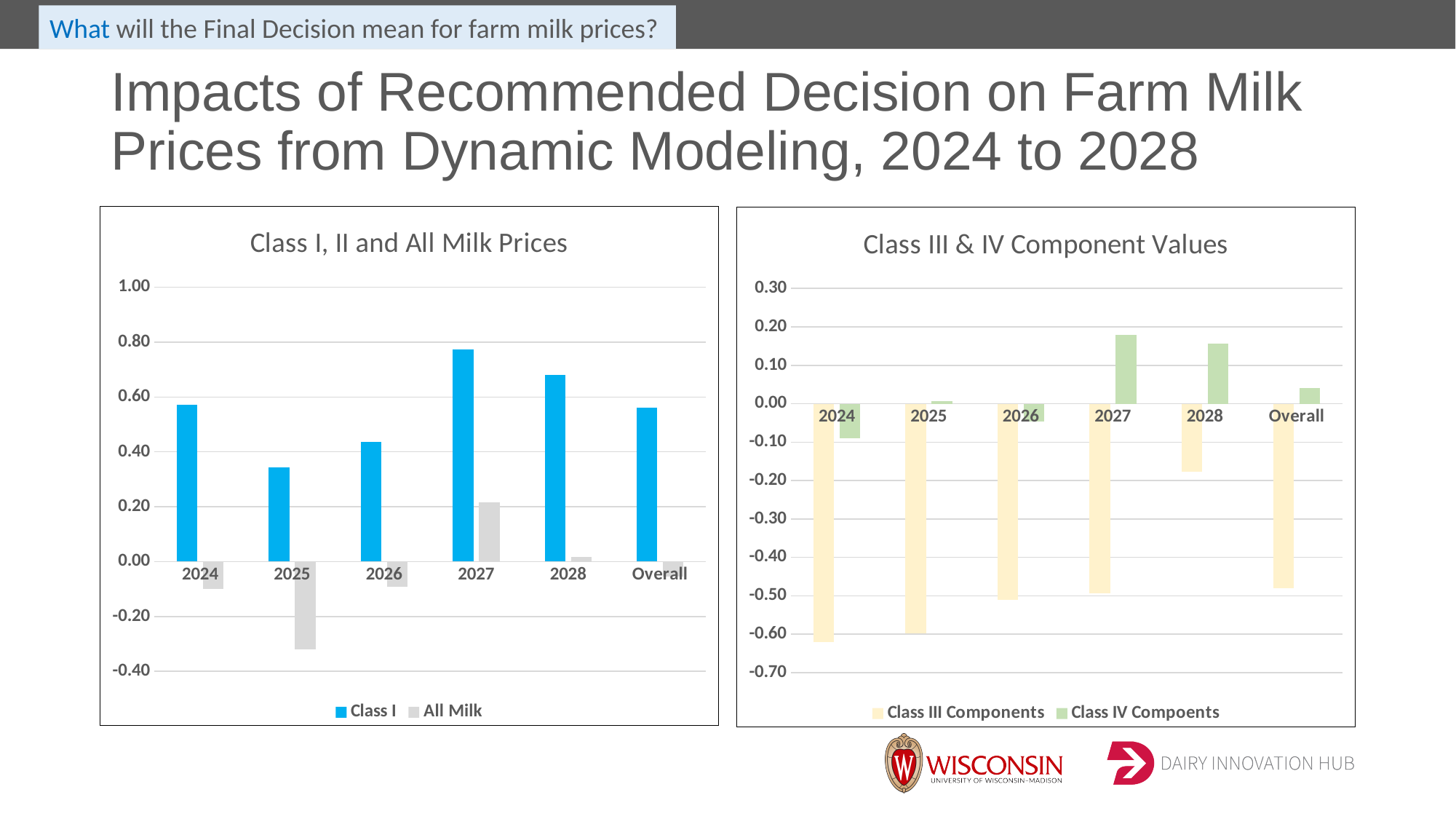
In the 'Class I, II and All Milk Prices' chart, which category has the highest Class I value? 2027 In the 'Class I, II and All Milk Prices' chart, is the Class I value for 2027 greater or less than 0.60? greater How many series does the legend of the 'Class I, II and All Milk Prices' chart list? 2 In the 'Class III & IV Component Values' chart, is the Class III Components value for 2024 greater or less than -0.50? less In the 'Class III & IV Component Values' chart, is the Class III Components value for 2028 greater or less than -0.40? greater How many categories are shown on the x axis of the 'Class III & IV Component Values' chart? 6 In the 'Class III & IV Component Values' chart, which category has the lowest Class IV Compoents value? 2024 In the 'Class I, II and All Milk Prices' chart, which is larger, the Class I value for 2024 or for 2026? 2024 What kind of chart is the 'Class III & IV Component Values' chart? bar chart In the 'Class I, II and All Milk Prices' chart, which category has the lowest Class I value? 2025 In the 'Class I, II and All Milk Prices' chart, which category has the lowest All Milk value? 2025